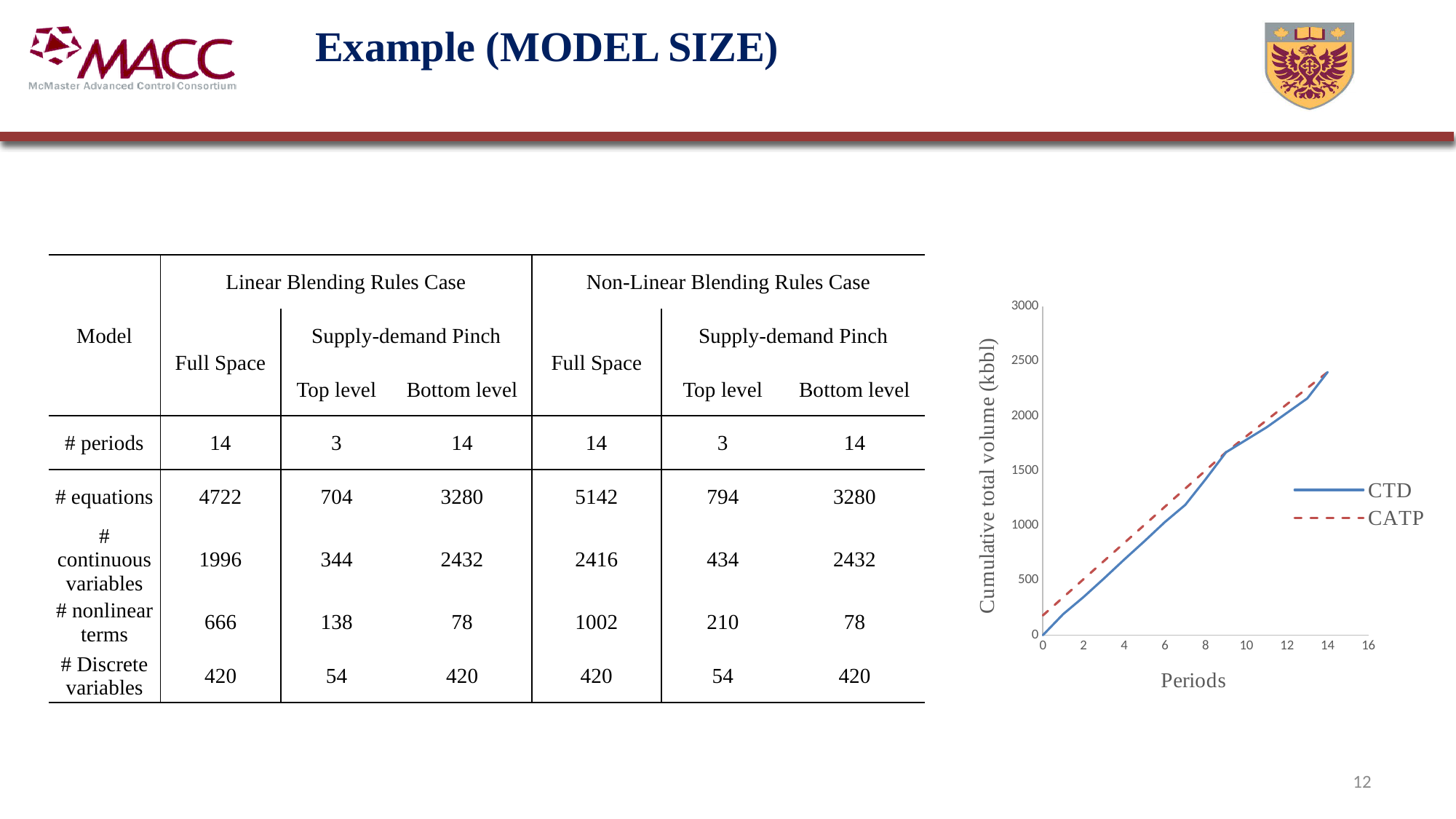
What are the two series named in the legend of the line chart? CTD and CATP Is the CTD value at period 7 greater or less than 1000? greater Do the CTD values rise or fall as Periods increase along the x axis? rise How many series does the legend of the line chart list? 2 At period 4, which series has the higher value, CTD or CATP? CATP What kind of chart is shown on the right of the slide? line chart Is the CATP value at period 10 greater or less than 1500? greater Is the CATP value at period 0 greater or less than 500? less What is the title of the y axis of the line chart? Cumulative total volume (kbbl) Do the CATP values rise or fall as Periods increase along the x axis? rise